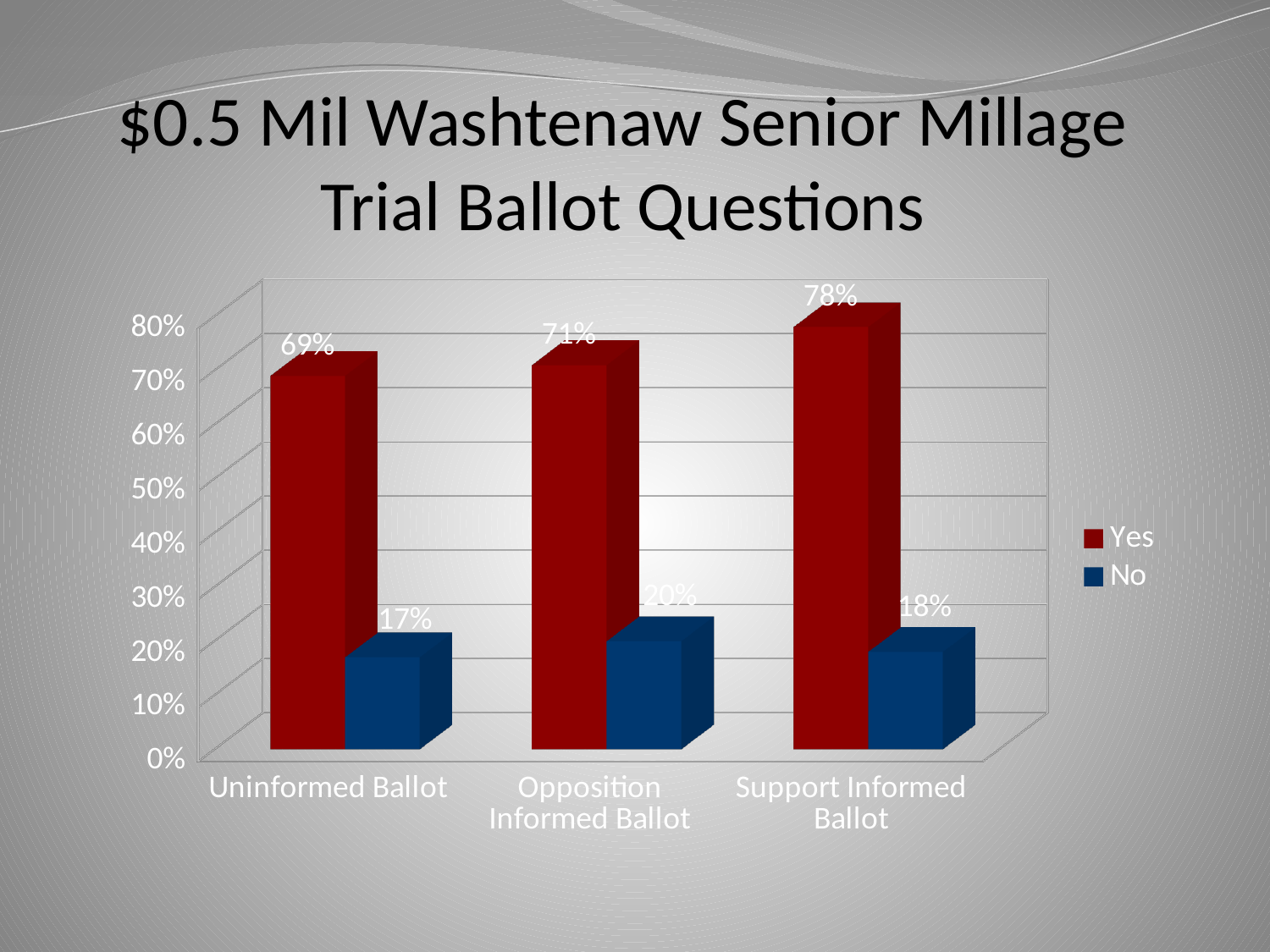
Which category has the highest Yes value? Support Informed Ballot What is the No value for Support Informed Ballot? 18% What is the Yes value for Support Informed Ballot? 78% What is the No value for Opposition Informed Ballot? 20% Which category has the lowest No value? Uninformed Ballot What is the difference between the Yes values for Support Informed Ballot and Uninformed Ballot? 9% What is the Yes value for Uninformed Ballot? 69% What kind of chart is shown on the slide? Bar chart Which is larger, the No value for Opposition Informed Ballot or the No value for Uninformed Ballot? Opposition Informed Ballot How many categories are shown on the x axis? 3 How many series does the legend list? 2 Do the Yes values rise or fall from Uninformed Ballot to Support Informed Ballot? Rise